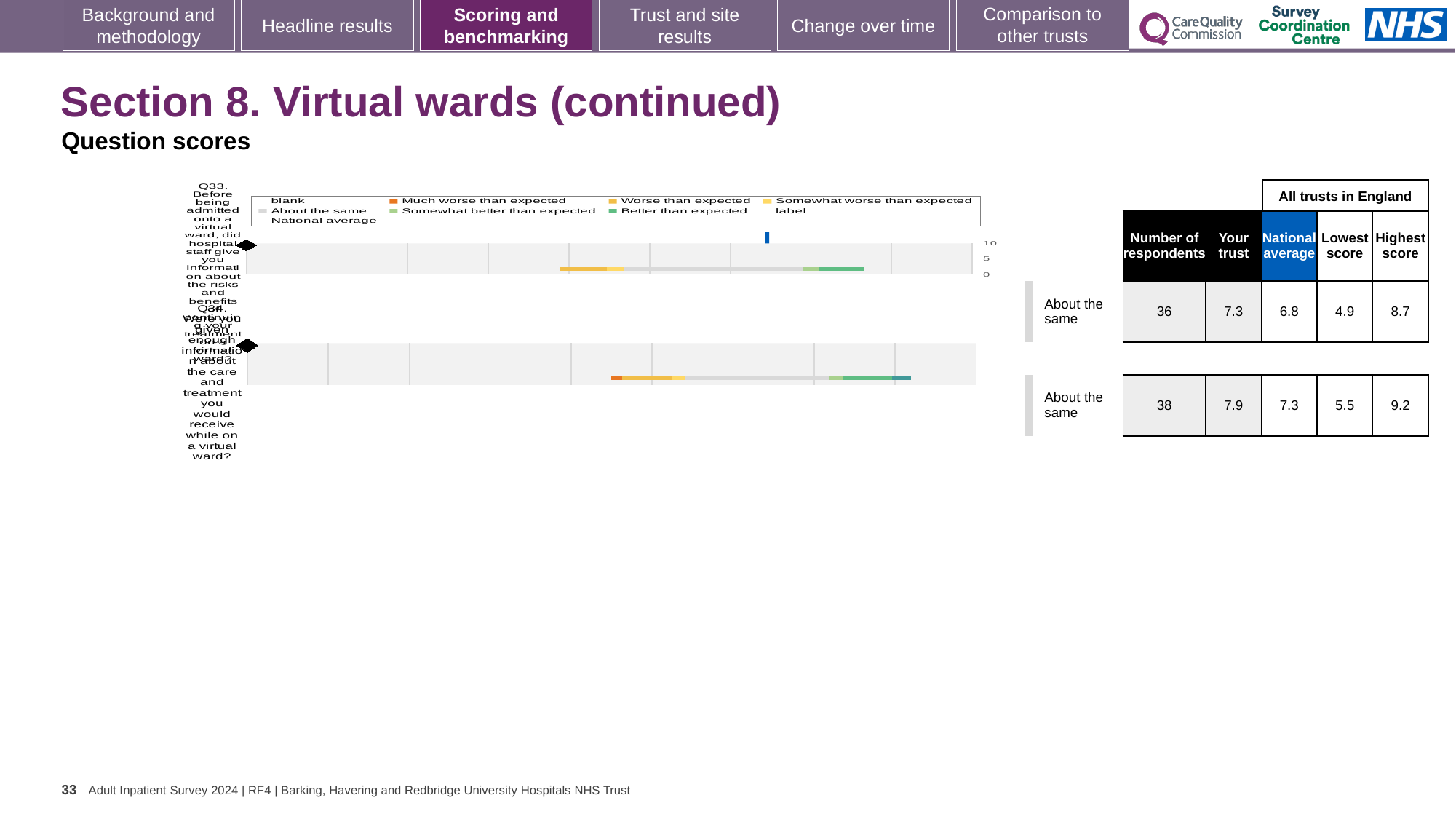
What is the highest value shown on the chart's score axis? 10 What is the highest score across all trusts in England for Q34? 9.2 What kind of chart is shown on the slide? bar chart What is the 'Your trust' score for Q34 in the table beside the chart? 7.9 What is the national average score for Q33? 6.8 What is the difference between the 'Your trust' scores for Q34 and Q33? 0.6 How many questions (bars) are plotted in the chart? 2 What benchmark category is given for Q33 next to the chart? About the same What is the number of respondents for Q34? 38 What colour does the legend use for 'Much worse than expected'? orange What is the 'Your trust' score for Q33 in the table beside the chart? 7.3 Which question has the higher 'Your trust' score, Q33 or Q34? Q34